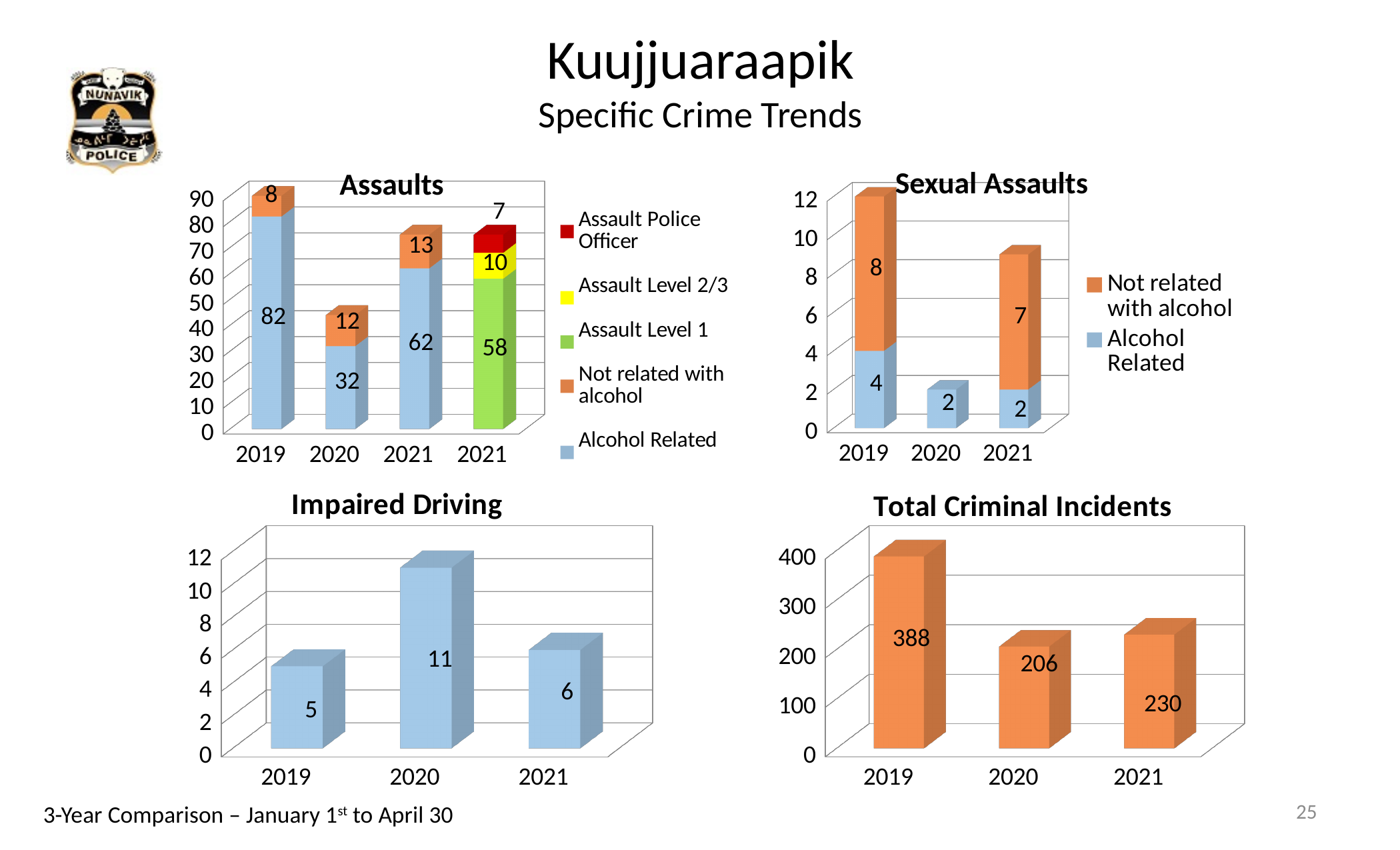
In the Assaults chart, what is the total of the stacked bar for 2019? 90 In the Sexual Assaults chart, what is the total of the stacked bar for 2019? 12 In the Impaired Driving chart, which year has the highest value? 2020 In the Sexual Assaults chart, how many series does the legend list? 2 In the Total Criminal Incidents chart, which year has the lowest value? 2020 What kind of chart is the Total Criminal Incidents chart? Bar chart In the Impaired Driving chart, how many bars are plotted? 3 In the Sexual Assaults chart, what is the Not related with alcohol value for 2021? 7 In the Assaults chart, what is the Alcohol Related value for 2020? 32 In the Total Criminal Incidents chart, what is the difference between the 2019 and 2021 values? 158 In the Impaired Driving chart, what is the value for 2021? 6 In the Total Criminal Incidents chart, what is the value for 2019? 388